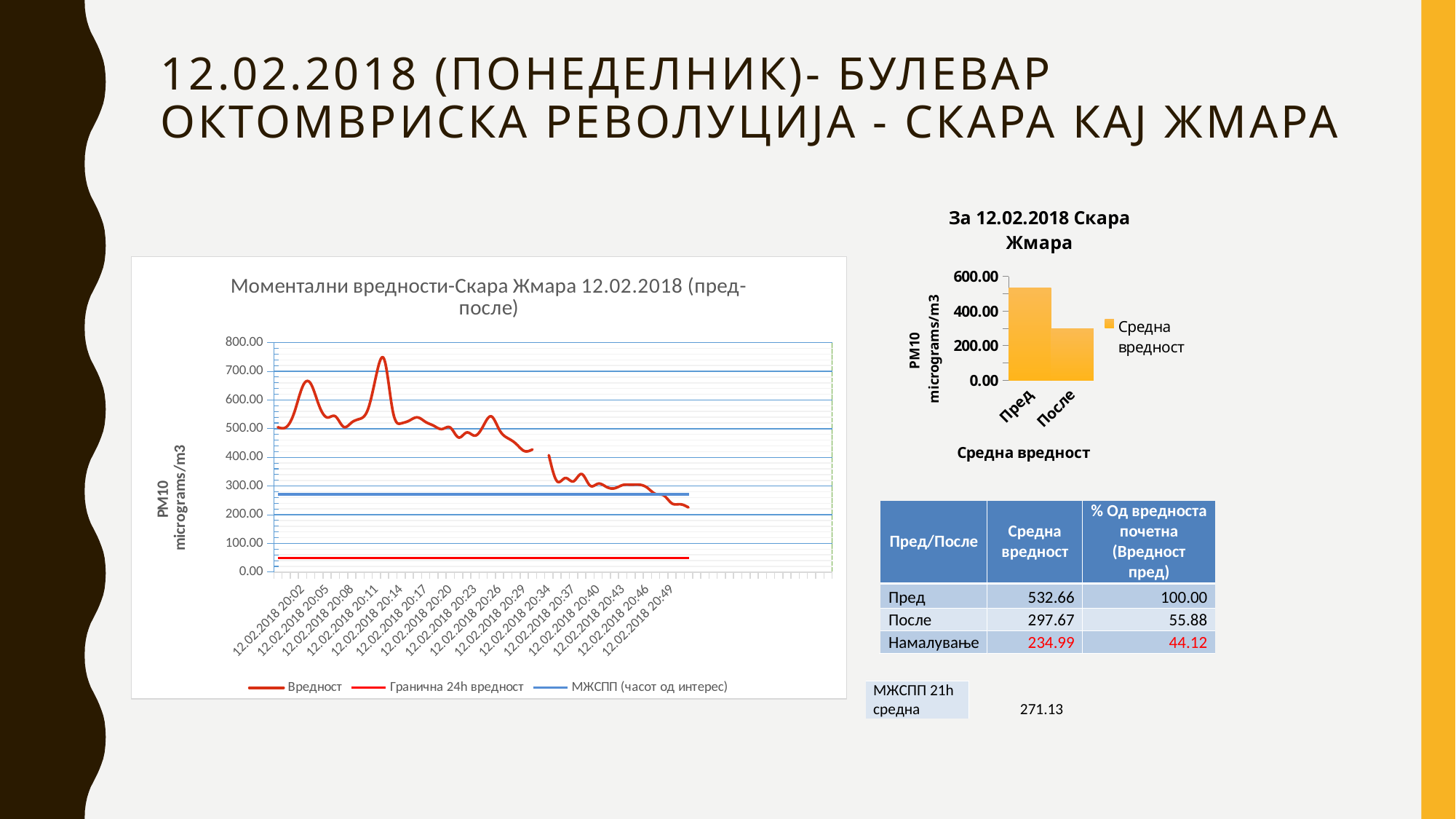
In the bar chart 'За 12.02.2018 Скара Жмара', which category has the highest value? Пред What kind of chart is the chart titled 'За 12.02.2018 Скара Жмара'? bar chart How many series does the legend of the line chart 'Моментални вредности-Скара Жмара 12.02.2018 (пред-после)' list? 3 What is the highest tick value on the y axis of the line chart 'Моментални вредности-Скара Жмара 12.02.2018 (пред-после)'? 800.00 In the line chart 'Моментални вредности-Скара Жмара 12.02.2018 (пред-после)', is the last value of the 'Вредност' series greater or less than 300.00? less In the line chart 'Моментални вредности-Скара Жмара 12.02.2018 (пред-после)', is the highest peak of the 'Вредност' series greater or less than 700.00? greater In the bar chart 'За 12.02.2018 Скара Жмара', is the value for 'После' greater or less than 400.00? less What series name does the legend of the bar chart 'За 12.02.2018 Скара Жмара' show? Средна вредност How many categories are shown in the bar chart 'За 12.02.2018 Скара Жмара'? 2 In the line chart 'Моментални вредности-Скара Жмара 12.02.2018 (пред-после)', do the 'Вредност' values overall rise or fall along the x axis? fall What kind of chart is the chart titled 'Моментални вредности-Скара Жмара 12.02.2018 (пред-после)'? line chart